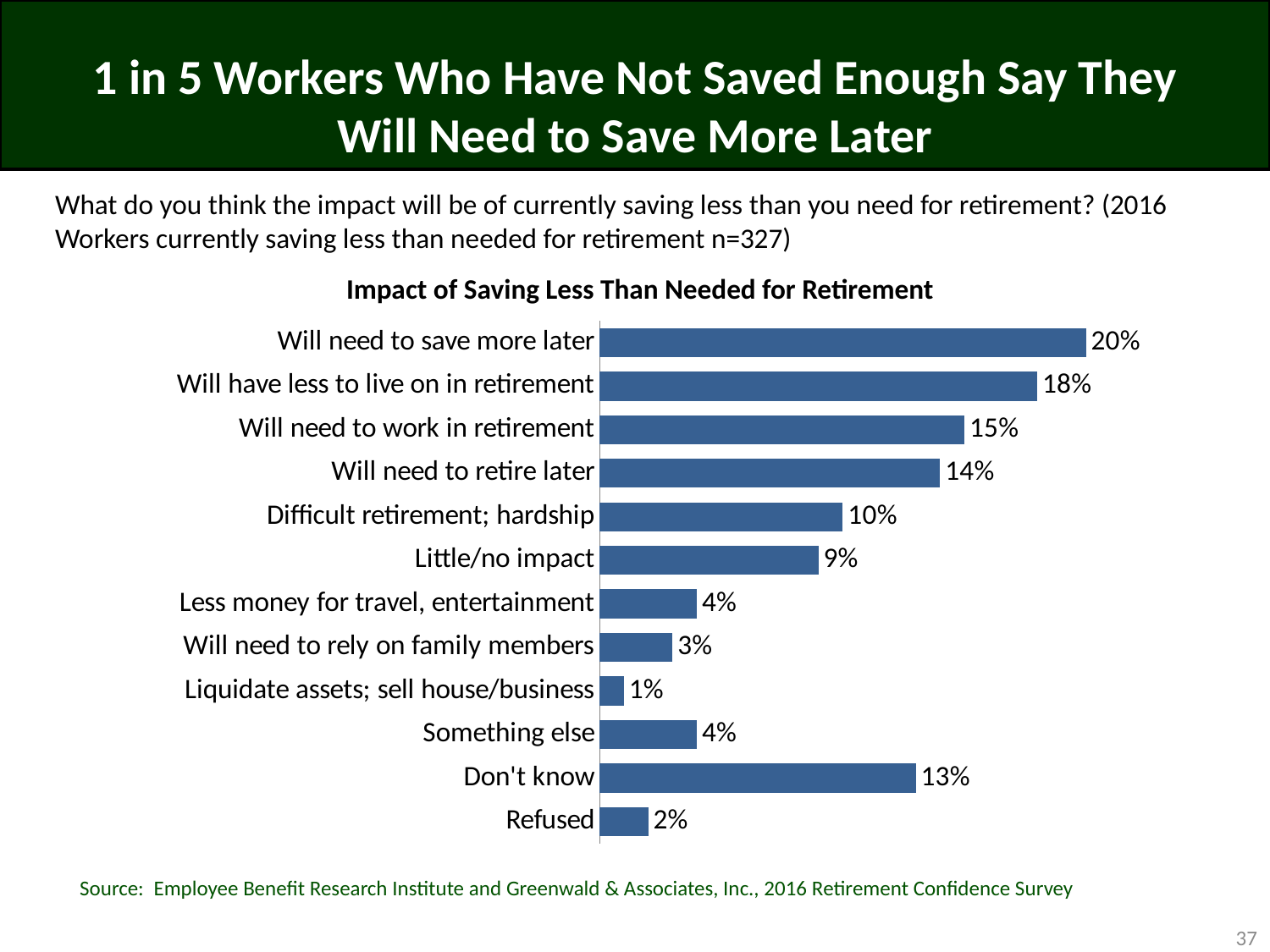
Which is larger: "Difficult retirement; hardship" or "Little/no impact"? Difficult retirement; hardship What is the difference between "Will have less to live on in retirement" and "Will need to retire later"? 4% Which category has the lowest value in the chart? Liquidate assets; sell house/business What is the difference between "Will need to save more later" and "Refused"? 18% What percentage of workers said they will need to save more later? 20% What is the value for "Will need to rely on family members"? 3% Which category has the highest value in the chart? Will need to save more later What percentage of respondents answered "Don't know"? 13% What is the title of the chart? Impact of Saving Less Than Needed for Retirement What is the value for "Will need to work in retirement"? 15% What type of chart is shown on the slide? Bar chart How many categories are shown in the chart? 12